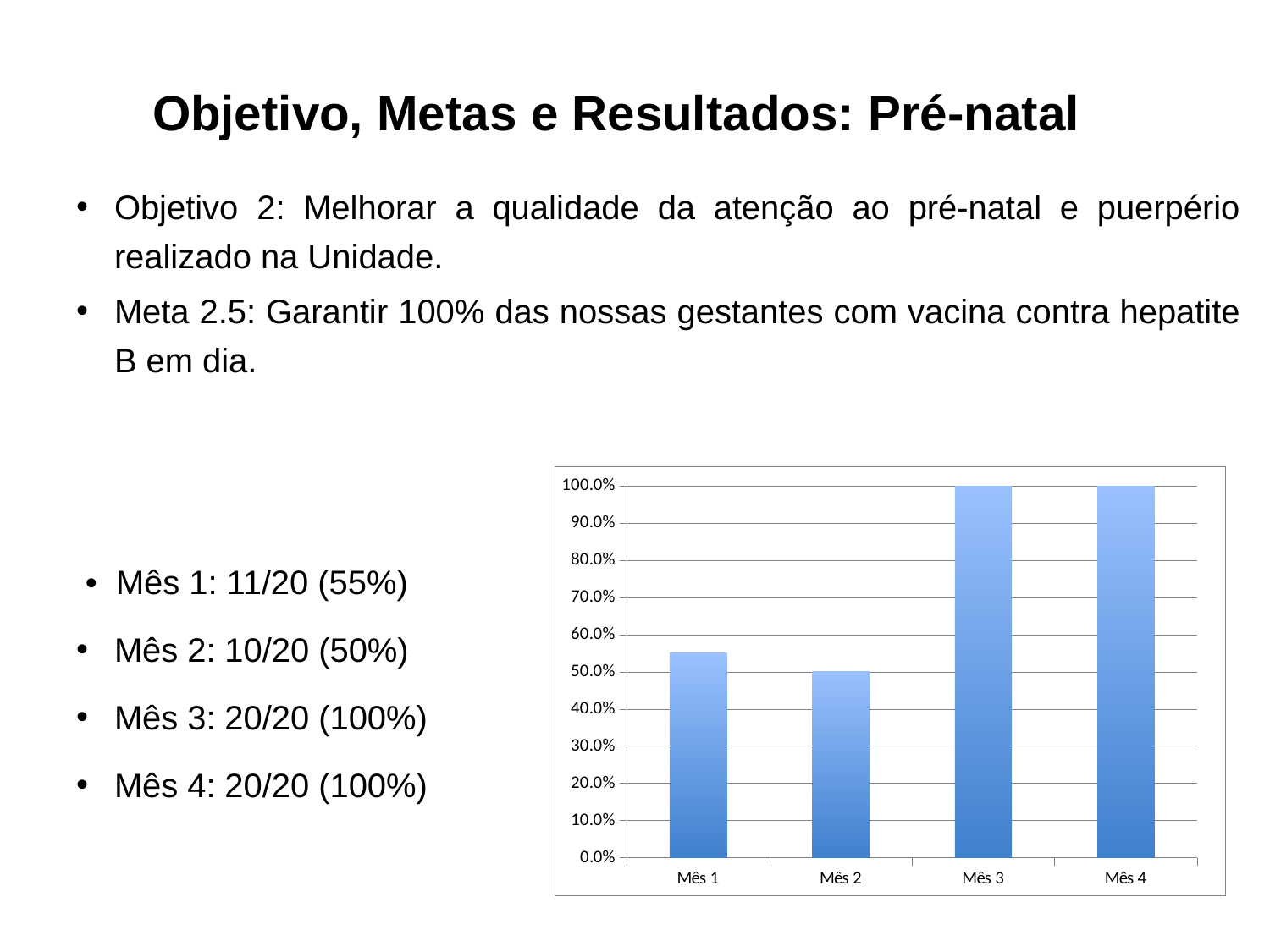
What is the value for Mês 1 on the chart? 55% Which is larger on the chart, the value for Mês 1 or the value for Mês 2? Mês 1 What is the value for Mês 3 on the chart? 100.0% Which month has the lowest value on the chart? Mês 2 What is the highest value shown on the chart's vertical axis? 100.0% What is the value for Mês 4 on the chart? 100.0% What is the difference between the value for Mês 3 and the value for Mês 2? 50 percentage points What is the value for Mês 2 on the chart? 50.0% Is the value for Mês 1 greater or less than 50.0%? greater Is the value for Mês 2 greater or less than 60.0%? less What kind of chart is shown on the slide? bar chart How many categories (months) are plotted on the chart? 4